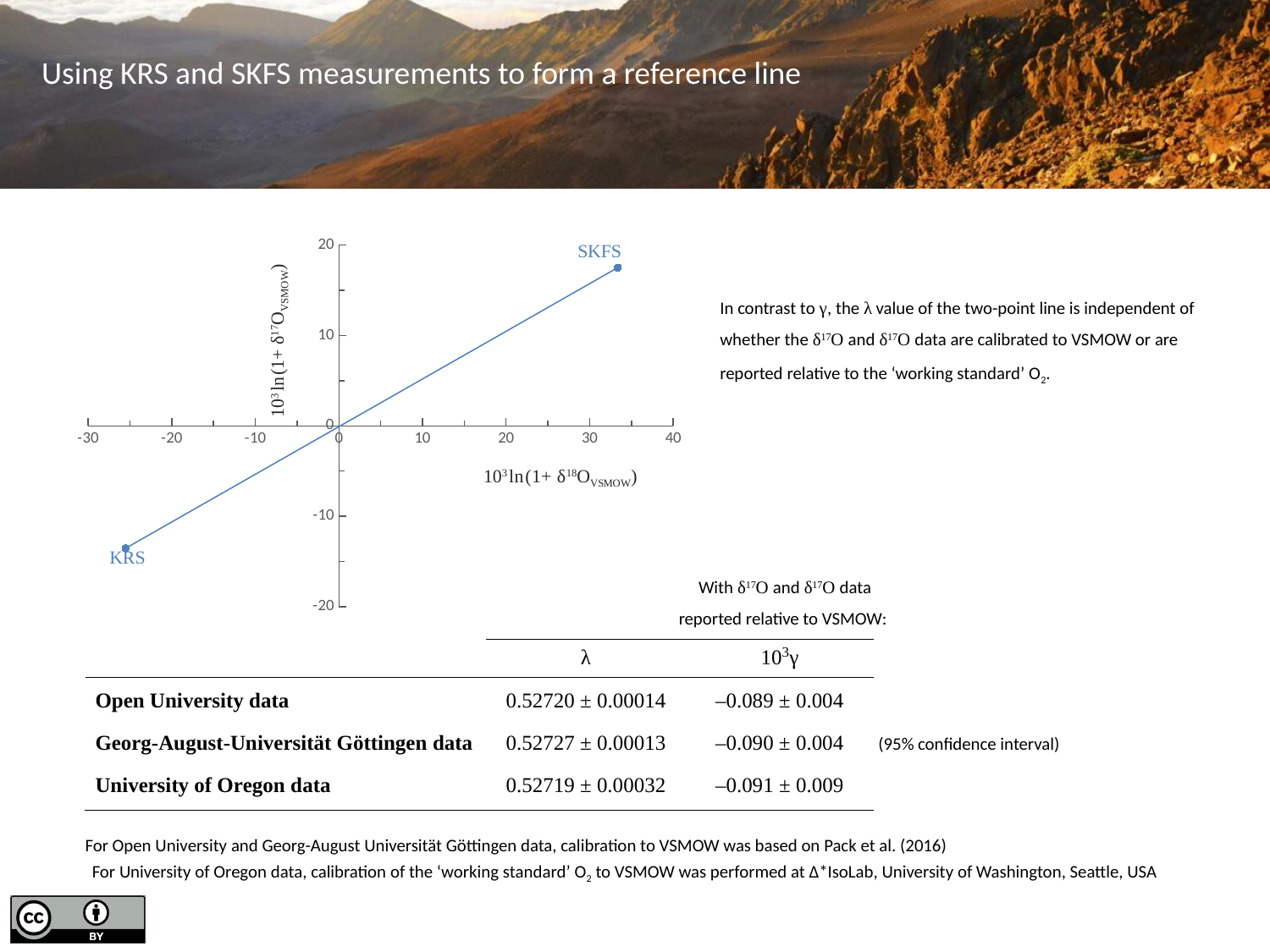
Which plotted point has the higher y value, KRS or SKFS? SKFS What is the maximum value shown on the x axis? 40 Is the x value for KRS greater or less than -20? less Which plotted point has the lowest x value? KRS Is the y value for KRS greater or less than -10? less What kind of chart is shown on the slide? scatter chart Is the y value for SKFS greater or less than 20? less What are the labels of the two plotted points? KRS and SKFS Does the line through the points rise or fall as the x value increases? rises How many data points are plotted on the chart? 2